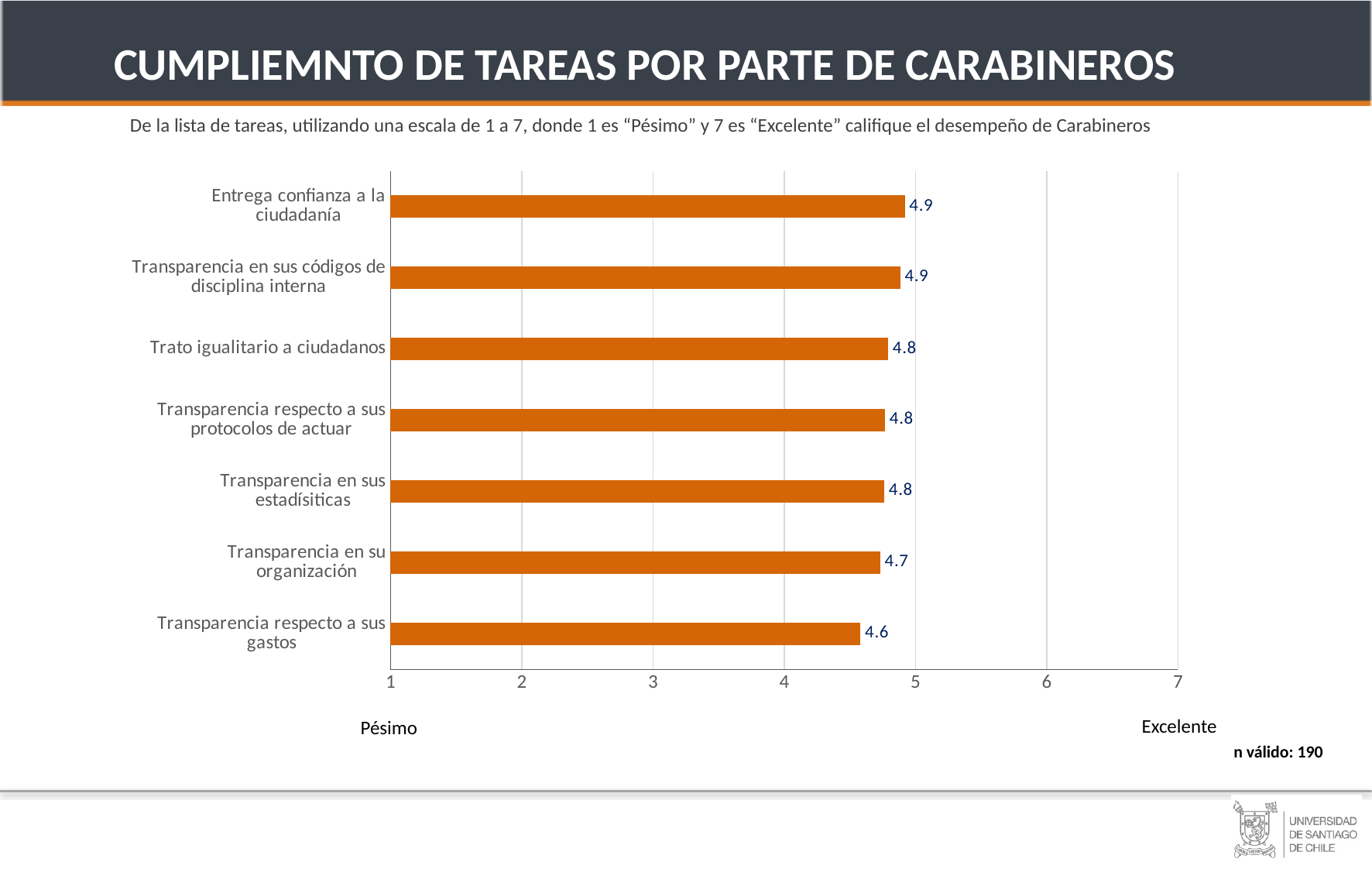
Which category has the lowest value? Transparencia respecto a sus gastos What is the value for "Trato igualitario a ciudadanos"? 4.8 What is the difference between the values for "Entrega confianza a la ciudadanía" and "Transparencia respecto a sus gastos"? 0.3 What is the highest value shown on the horizontal axis? 7 What is the valid n reported on the slide? 190 What is the value for "Transparencia respecto a sus gastos"? 4.6 What is the value for "Transparencia en su organización"? 4.7 Which is larger, the value for "Transparencia en sus códigos de disciplina interna" or the value for "Transparencia en su organización"? Transparencia en sus códigos de disciplina interna What kind of chart is shown on the slide? bar chart How many categories are shown in the chart? 7 What is the value for "Entrega confianza a la ciudadanía"? 4.9 Is the value for "Transparencia respecto a sus gastos" greater or less than 5? less